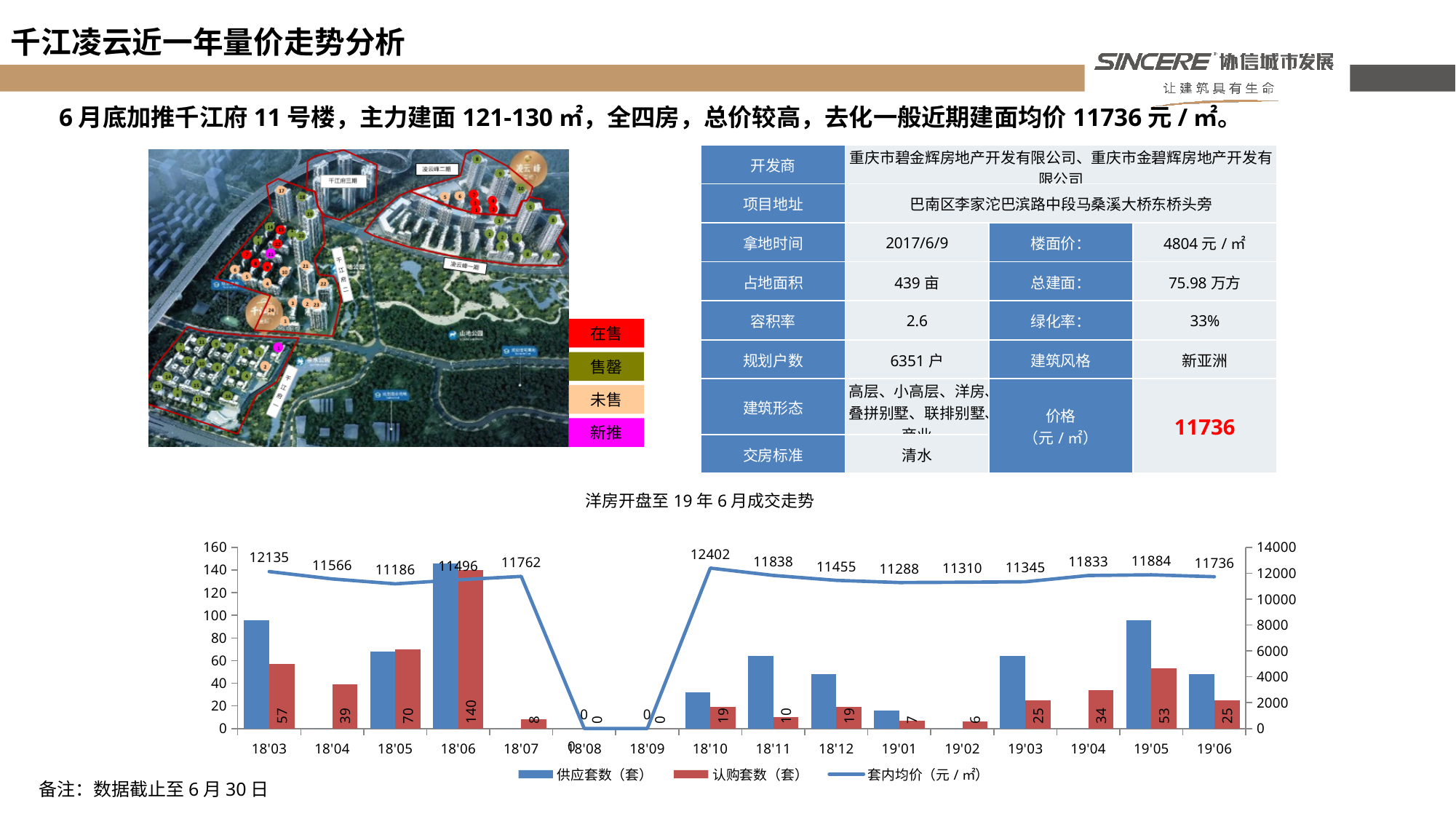
What kind of chart is 洋房开盘至19年6月成交走势? Combined bar and line chart In the chart 洋房开盘至19年6月成交走势, which month has the highest 套内均价（元/㎡）? 18'10 In the chart 洋房开盘至19年6月成交走势, is the 供应套数（套） value for 18'03 greater or less than 80? greater In the chart 洋房开盘至19年6月成交走势, which is higher, the 套内均价（元/㎡） for 18'03 or for 18'11? 18'03 How many series does the legend of the chart 洋房开盘至19年6月成交走势 list? 3 In the chart 洋房开盘至19年6月成交走势, what is the difference between the 套内均价（元/㎡） values for 19'05 and 19'06? 148 In the chart 洋房开盘至19年6月成交走势, what is the 套内均价（元/㎡） value for 19'06? 11736 In the chart 洋房开盘至19年6月成交走势, what is the 认购套数（套） value for 19'04? 34 In the chart 洋房开盘至19年6月成交走势, what is the 认购套数（套） value for 18'06? 140 How many months are shown on the x axis of the chart 洋房开盘至19年6月成交走势? 16 In the chart 洋房开盘至19年6月成交走势, what is the difference between the 认购套数（套） values for 18'03 and 18'04? 18 In the chart 洋房开盘至19年6月成交走势, which month has the highest 认购套数（套）? 18'06